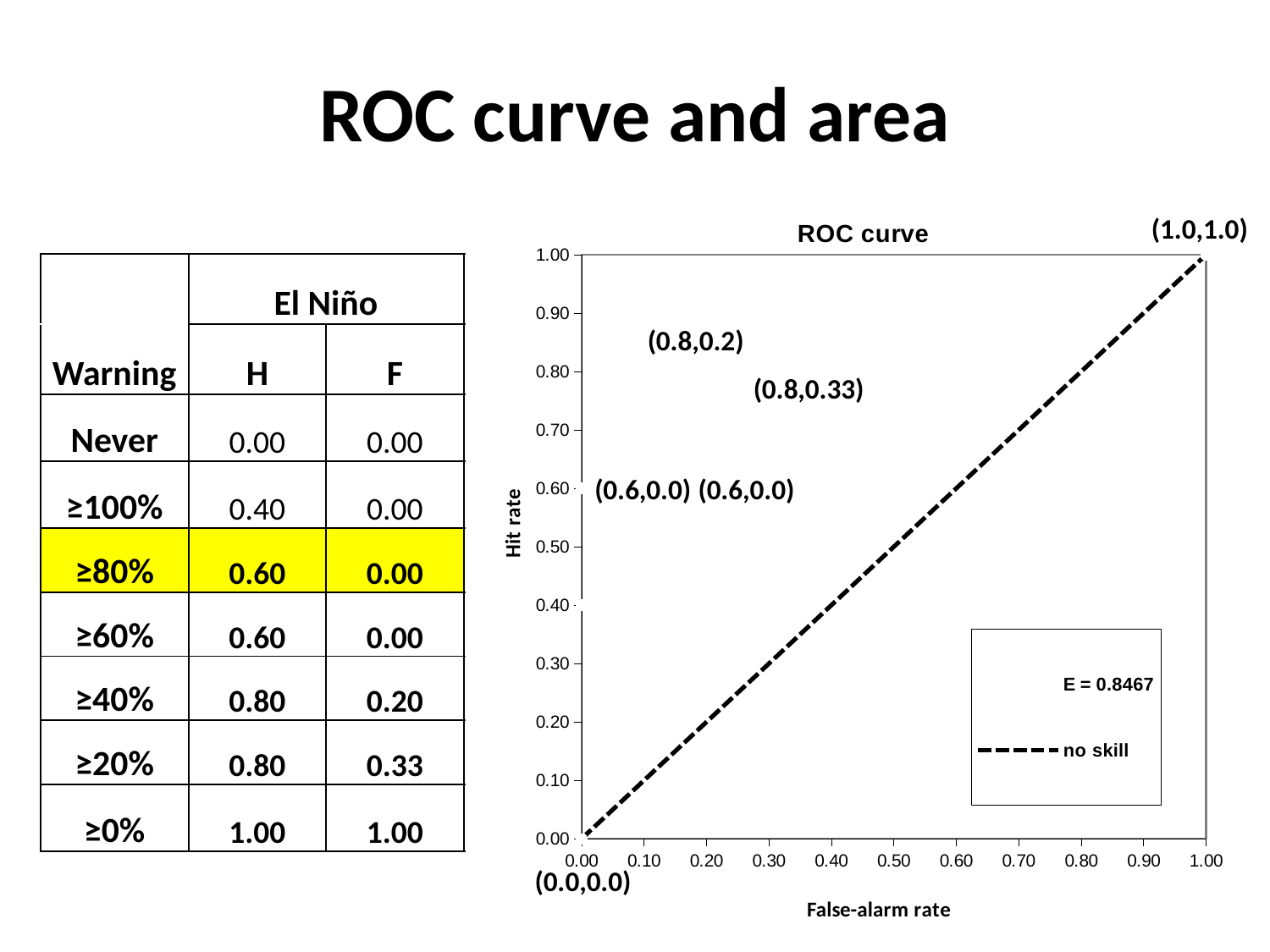
Is the hit rate of the no skill line at a false-alarm rate of 0.50 greater or less than 0.90? less What is the legend label of the dashed diagonal line? no skill What is the label of the y axis of the chart? Hit rate What coordinate label is printed at the bottom left origin of the chart? (0.0,0.0) What is the title of the chart? ROC curve What is the hit rate of the no skill line at a false-alarm rate of 1.00? 1.00 What coordinate label is printed at the top right end of the no skill line? (1.0,1.0) What kind of chart is shown on the slide? line chart How many entries does the chart's legend list? 2 What is the label of the x axis of the chart? False-alarm rate What value of E is shown in the chart's legend? E = 0.8467 Does the no skill line rise or fall as the false-alarm rate increases? rises